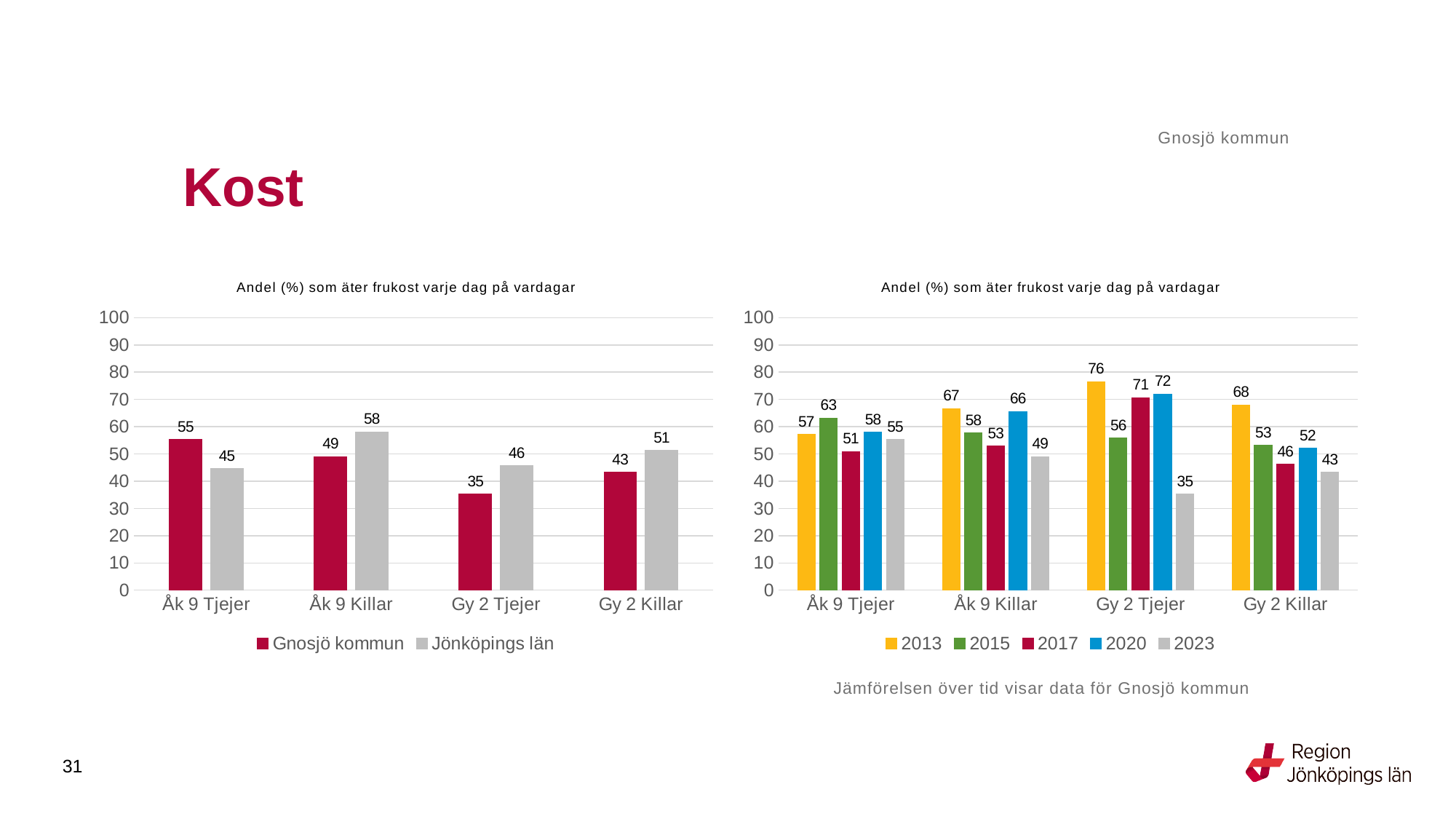
In the left chart, which is larger for Gy 2 Killar: Gnosjö kommun or Jönköpings län? Jönköpings län How many series does the legend of the left chart list? 2 In the left chart, what is the value for Gnosjö kommun for Åk 9 Tjejer? 55 In the left chart, which category has the lowest value for Gnosjö kommun? Gy 2 Tjejer What type of chart is the right chart? Bar chart In the left chart, what is the value for Jönköpings län for Gy 2 Tjejer? 46 How many series does the legend of the right chart list? 5 In the right chart, what is the difference between the 2020 and 2023 values for Gy 2 Tjejer? 37 In the right chart, what is the value for 2013 for Gy 2 Tjejer? 76 In the left chart, what is the difference between Jönköpings län and Gnosjö kommun for Åk 9 Killar? 9 In the right chart, what is the value for 2023 for Åk 9 Killar? 49 In the right chart, which year has the highest value for Gy 2 Killar? 2013